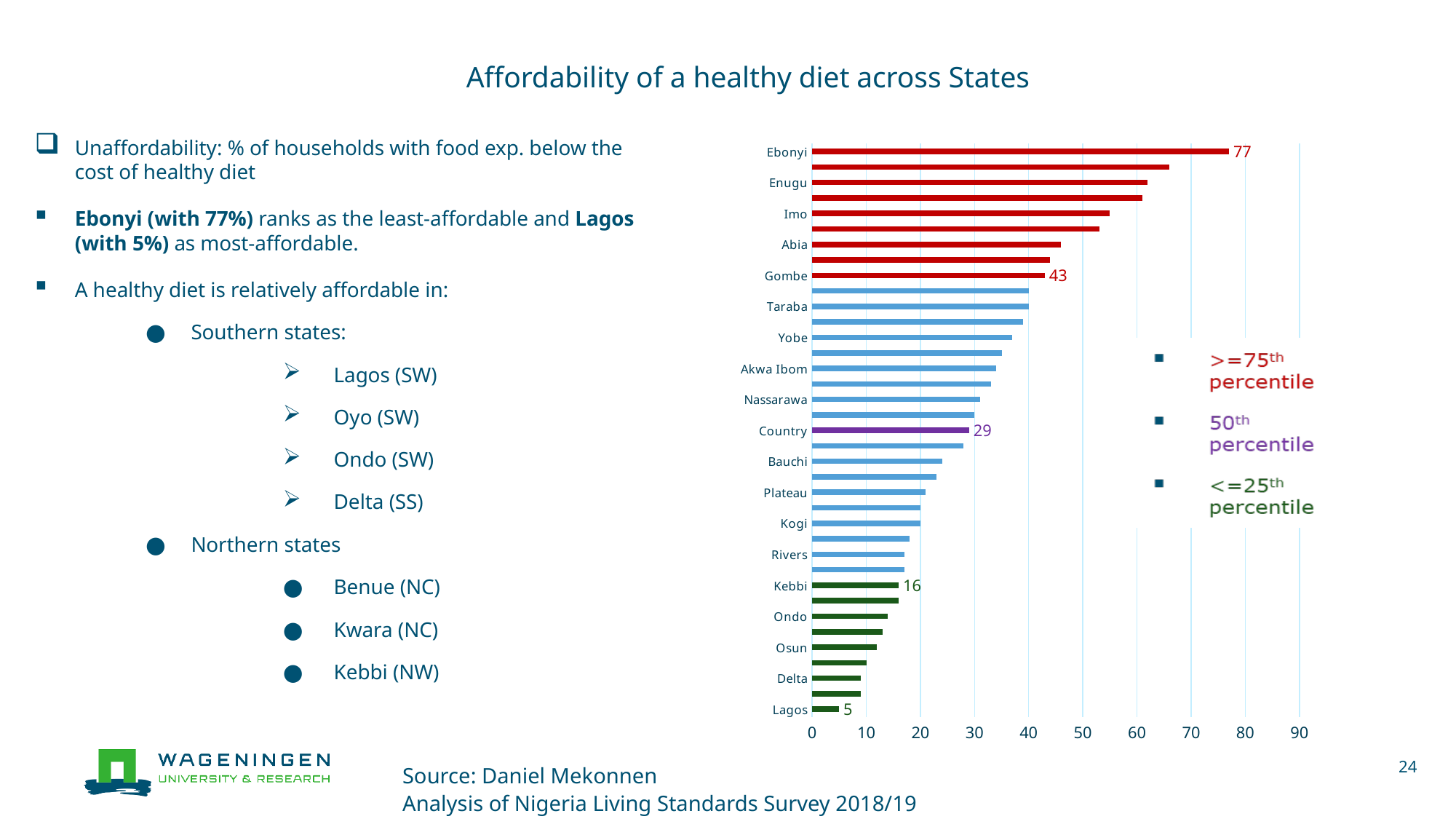
What is the value for Gombe? 43 Which is larger, the value for Gombe or the value for Country? Gombe How many entries does the legend list? 3 What is the value for Kebbi? 16 What is the value for Lagos? 5 What is the value for Country? 29 What is the difference between the values for Ebonyi and Lagos? 72 Is the value for Taraba greater or less than 30? greater Which state has the highest value in the chart? Ebonyi What kind of chart is shown on the slide? bar chart Which state has the lowest value in the chart? Lagos What is the value for Ebonyi? 77